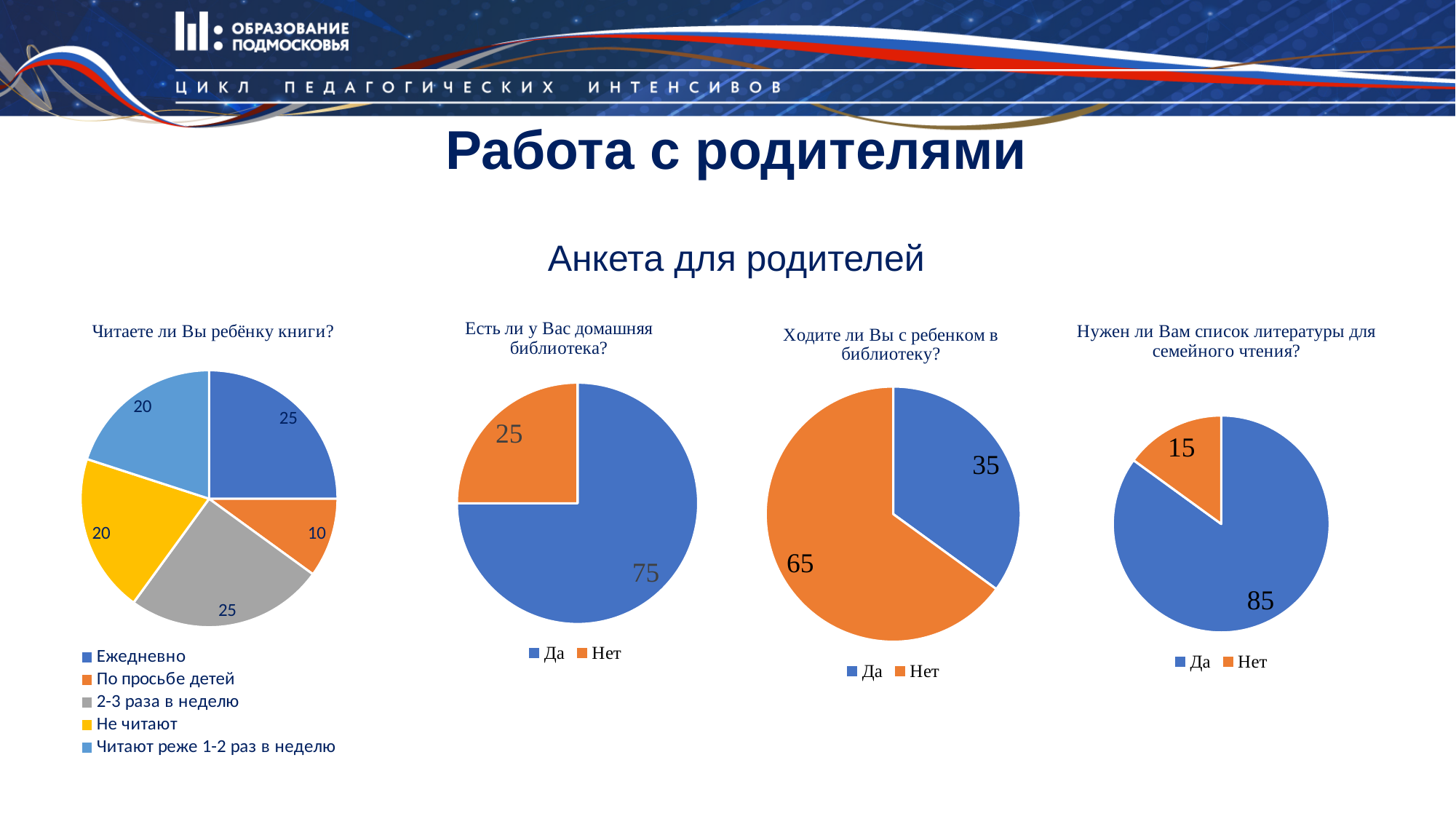
In the chart "Читаете ли Вы ребёнку книги?", which category has the lowest value? По просьбе детей How many charts are shown on the slide? 4 In the chart "Читаете ли Вы ребёнку книги?", what is the value for "Не читают"? 20 How many categories does the legend of the chart "Читаете ли Вы ребёнку книги?" list? 5 In the chart "Нужен ли Вам список литературы для семейного чтения?", what share of the pie does "Да" take? 85 In the chart "Ходите ли Вы с ребенком в библиотеку?", what is the value for "Нет"? 65 What kind of chart is the chart "Ходите ли Вы с ребенком в библиотеку?"? Pie chart In the chart "Ходите ли Вы с ребенком в библиотеку?", which is larger, "Да" or "Нет"? Нет In the chart "Нужен ли Вам список литературы для семейного чтения?", what is the value for "Нет"? 15 In the chart "Есть ли у Вас домашняя библиотека?", what is the value for "Да"? 75 In the chart "Есть ли у Вас домашняя библиотека?", what is the difference between "Да" and "Нет"? 50 In the chart "Читаете ли Вы ребёнку книги?", what is the value for "По просьбе детей"? 10